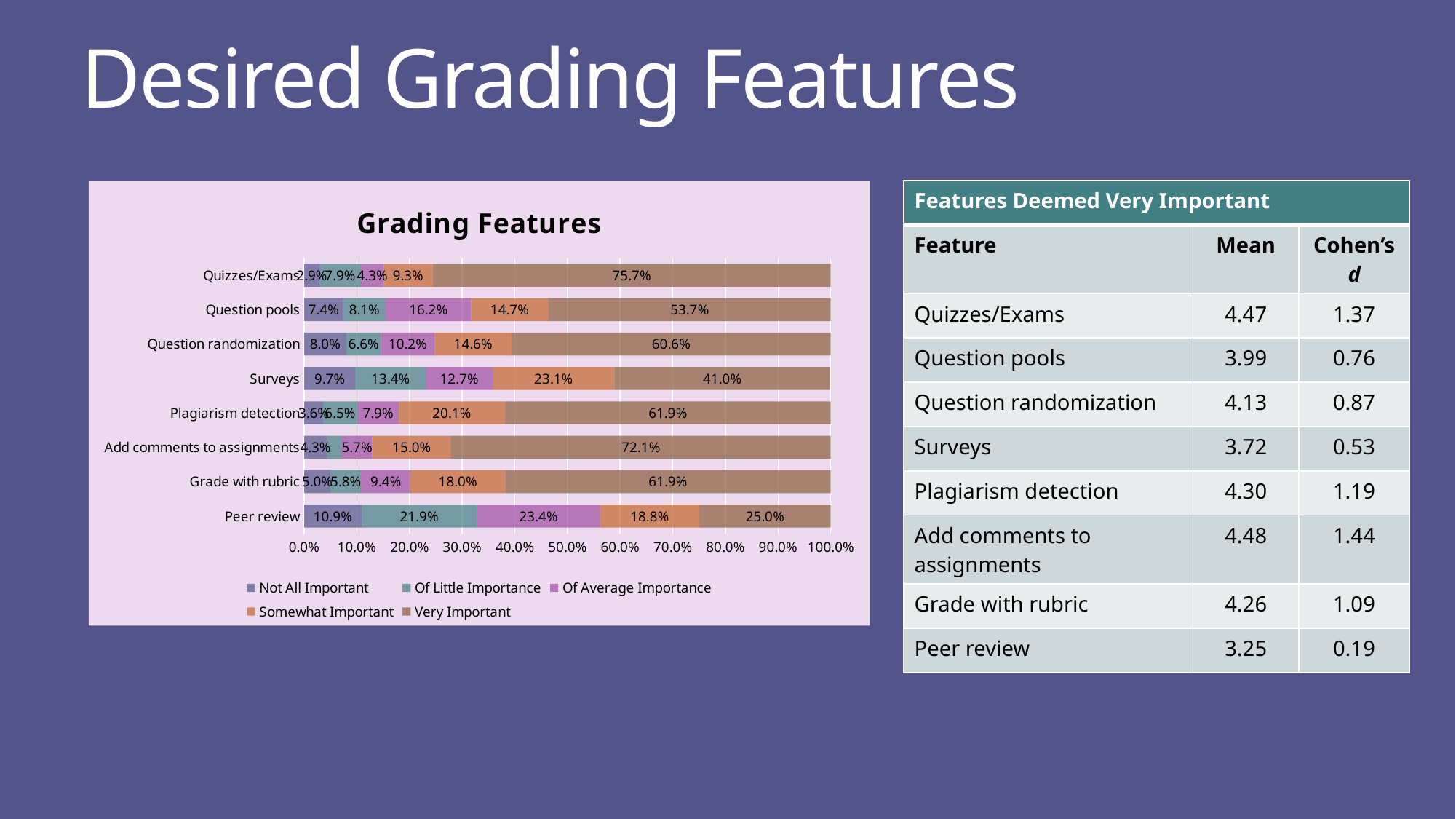
In the Grading Features chart, what percentage rated Quizzes/Exams as Very Important? 75.7% What type of chart is the Grading Features chart? Stacked bar chart In the Grading Features chart, what is the Not All Important value for Peer review? 10.9% How many series does the legend of the Grading Features chart list? 5 In the Grading Features chart, which has a larger Very Important percentage: Question pools or Question randomization? Question randomization In the Grading Features chart, which feature has the lowest Very Important percentage? Peer review In the Grading Features chart, which feature has the highest Very Important percentage? Quizzes/Exams How many grading features are listed in the Grading Features chart? 8 What is the title of the chart on the slide? Grading Features In the Grading Features chart, what is the Somewhat Important value for Surveys? 23.1% In the Grading Features chart, what is the Of Average Importance value for Question pools? 16.2% In the Grading Features chart, what is the difference between the Very Important percentages for Quizzes/Exams and Peer review? 50.7%